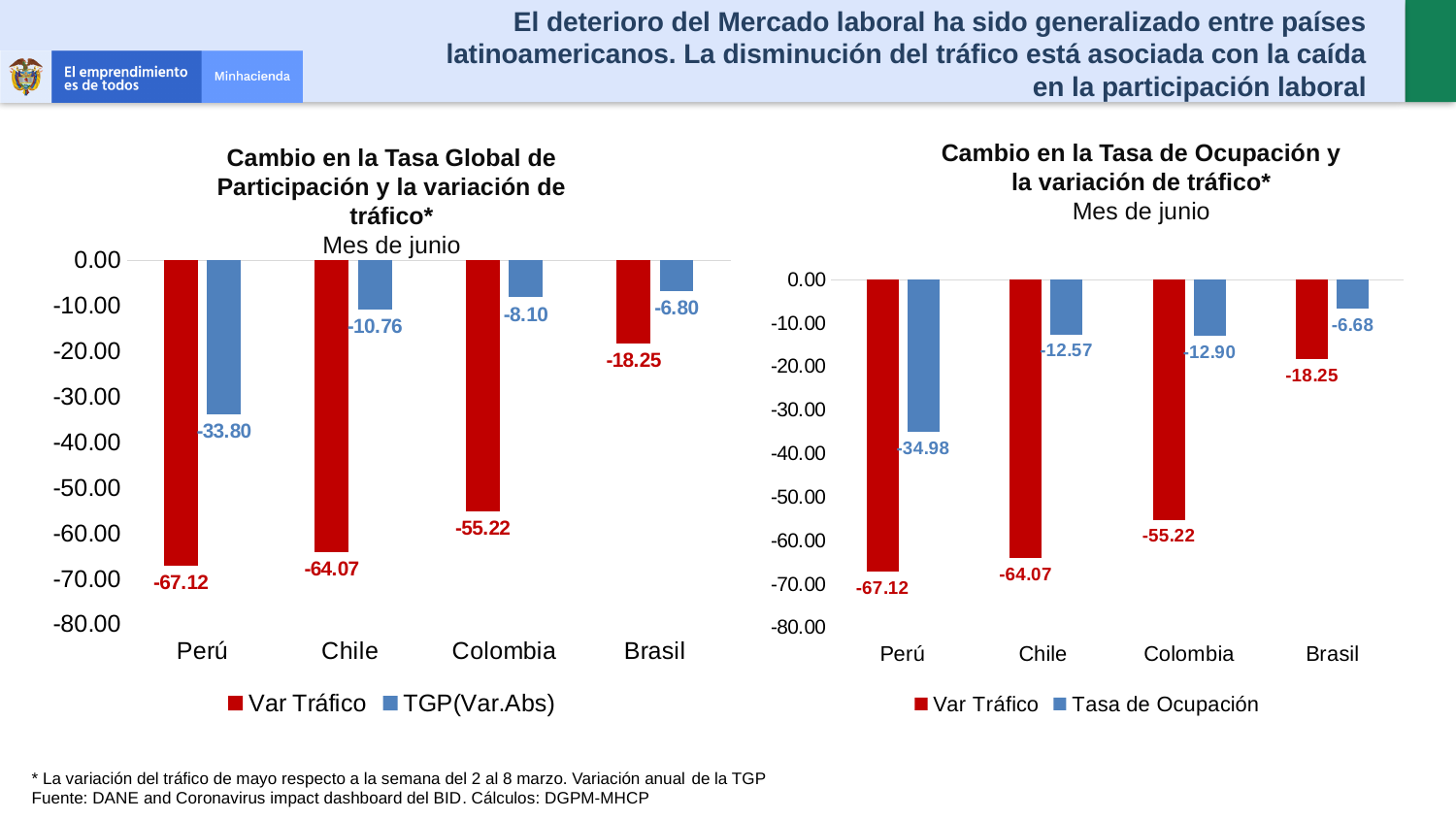
How many countries are shown on the x axis of the left chart (Cambio en la Tasa Global de Participación)? 4 In the left chart (Cambio en la Tasa Global de Participación), what is the difference between the Var Tráfico values for Perú and Brasil? 48.87 In the left chart (Cambio en la Tasa Global de Participación), what is the TGP(Var.Abs) value for Chile? -10.76 In the left chart (Cambio en la Tasa Global de Participación), what is the Var Tráfico value for Perú? -67.12 In the left chart (Cambio en la Tasa Global de Participación), which country has the lowest TGP(Var.Abs) value? Perú In the right chart (Cambio en la Tasa de Ocupación), what is the Var Tráfico value for Brasil? -18.25 In the right chart (Cambio en la Tasa de Ocupación), what is the Tasa de Ocupación value for Colombia? -12.90 In the right chart (Cambio en la Tasa de Ocupación), is the Tasa de Ocupación value for Perú greater or less than -30.00? less What type of chart is the left chart (Cambio en la Tasa Global de Participación)? Bar chart How many series does the legend of the right chart (Cambio en la Tasa de Ocupación) list? 2 In the right chart (Cambio en la Tasa de Ocupación), which country has the highest (least negative) Var Tráfico value? Brasil In the right chart (Cambio en la Tasa de Ocupación), which is larger, the Tasa de Ocupación value for Chile or for Brasil? Brasil